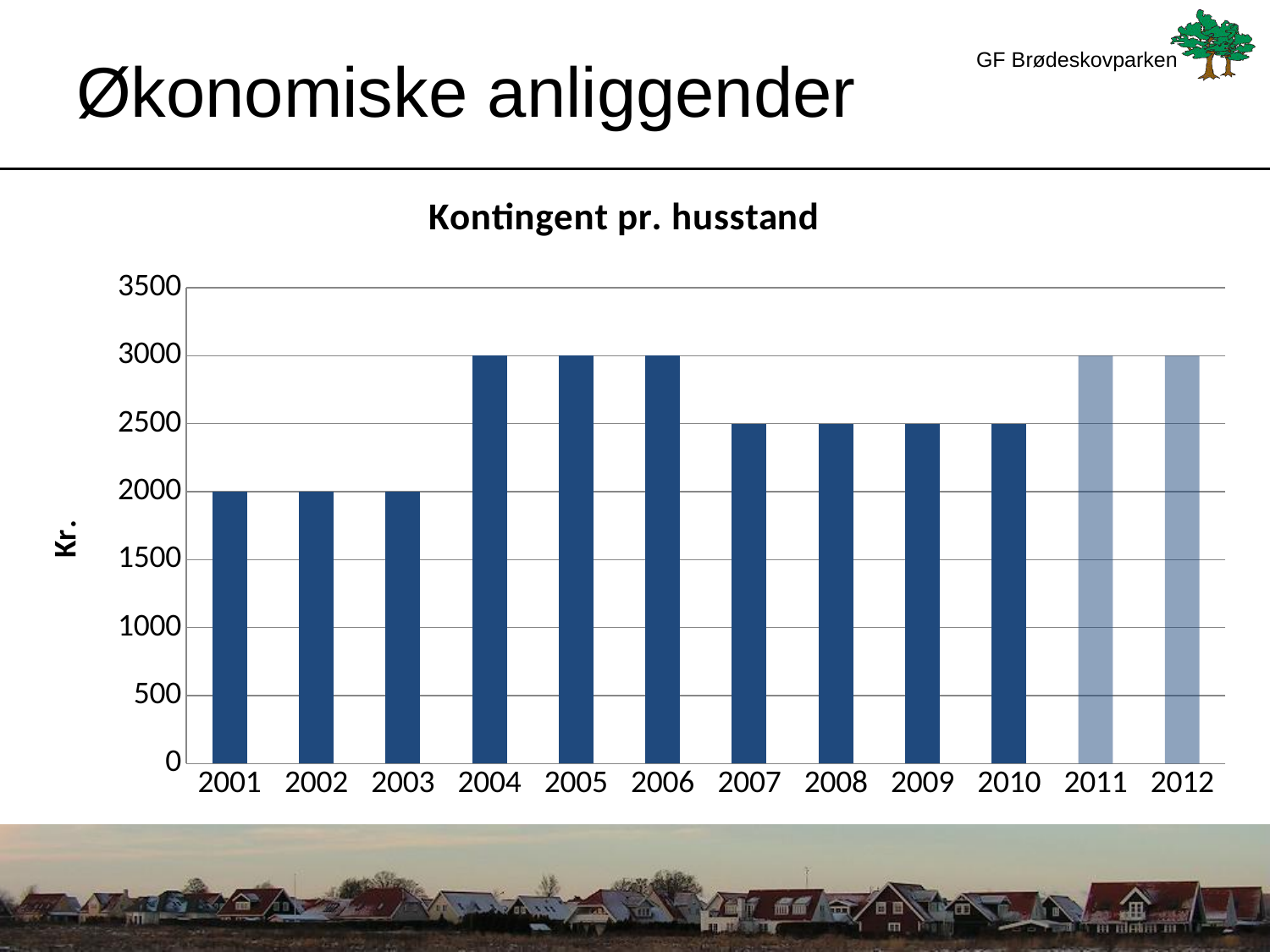
What is the value for 2001? 2000 What is the value for 2012? 3000 What is the value for 2005? 3000 What is the chart's title? Kontingent pr. husstand How many years are shown on the x axis of the chart? 12 What kind of chart is shown on the slide? bar chart What is the difference between the values for 2004 and 2003? 1000 What is the difference between the values for 2006 and 2007? 500 What is the label on the y axis? Kr. Is the value for 2010 greater or less than 3000? less What is the value for 2008? 2500 Which is larger, the value for 2002 or the value for 2009? 2009